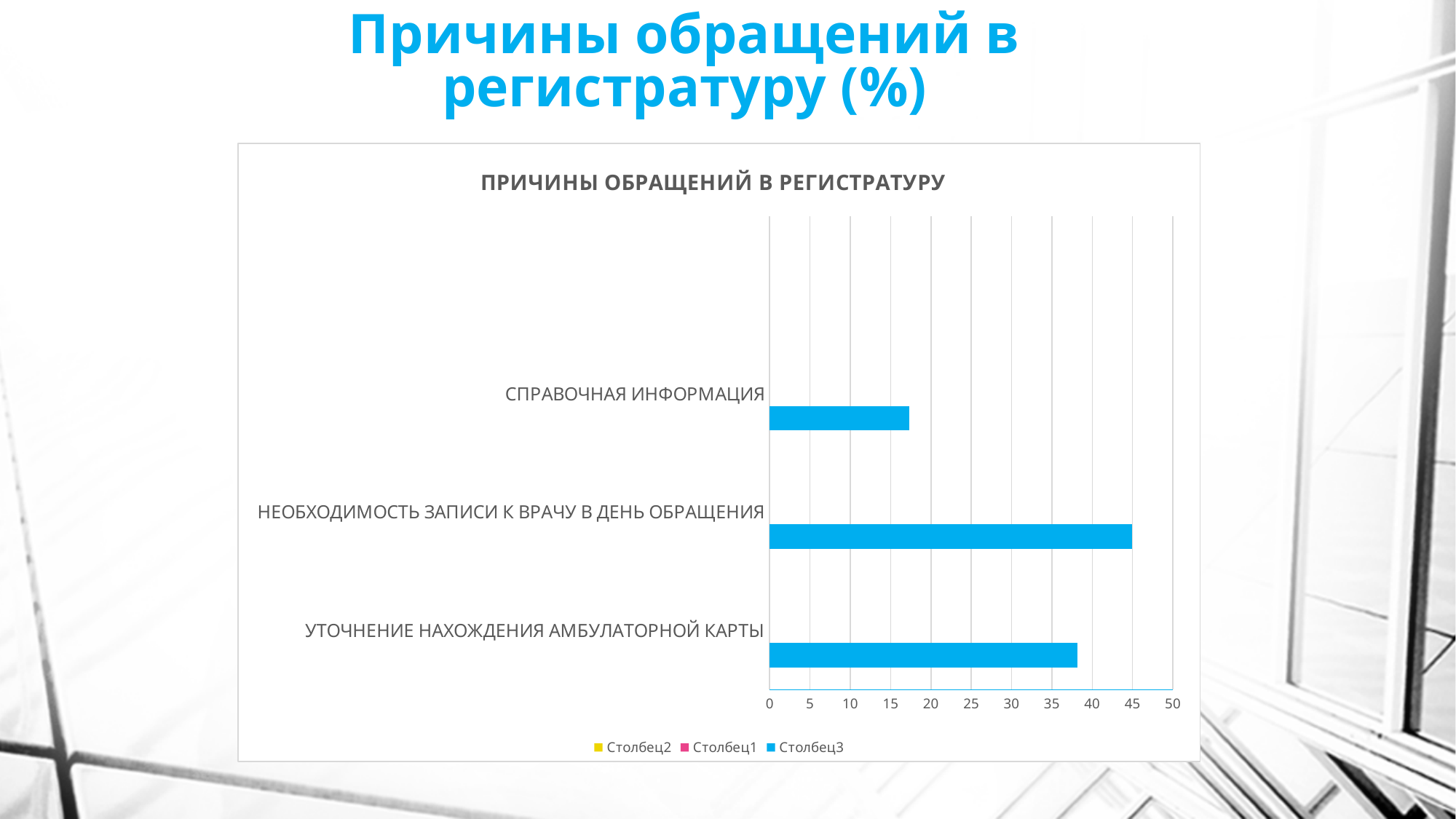
Is the value for УТОЧНЕНИЕ НАХОЖДЕНИЯ АМБУЛАТОРНОЙ КАРТЫ greater or less than 35? greater Which category has the lowest value? СПРАВОЧНАЯ ИНФОРМАЦИЯ Is the value for СПРАВОЧНАЯ ИНФОРМАЦИЯ greater or less than 20? less What kind of chart is shown on the slide? bar chart Which category has the highest value? НЕОБХОДИМОСТЬ ЗАПИСИ К ВРАЧУ В ДЕНЬ ОБРАЩЕНИЯ What is the maximum value shown on the horizontal axis? 50 Is the value for НЕОБХОДИМОСТЬ ЗАПИСИ К ВРАЧУ В ДЕНЬ ОБРАЩЕНИЯ greater or less than 40? greater Which is larger: the value for УТОЧНЕНИЕ НАХОЖДЕНИЯ АМБУЛАТОРНОЙ КАРТЫ or the value for СПРАВОЧНАЯ ИНФОРМАЦИЯ? УТОЧНЕНИЕ НАХОЖДЕНИЯ АМБУЛАТОРНОЙ КАРТЫ What is the title of the chart? ПРИЧИНЫ ОБРАЩЕНИЙ В РЕГИСТРАТУРУ How many categories are plotted in the chart? 3 How many series does the chart legend list? 3